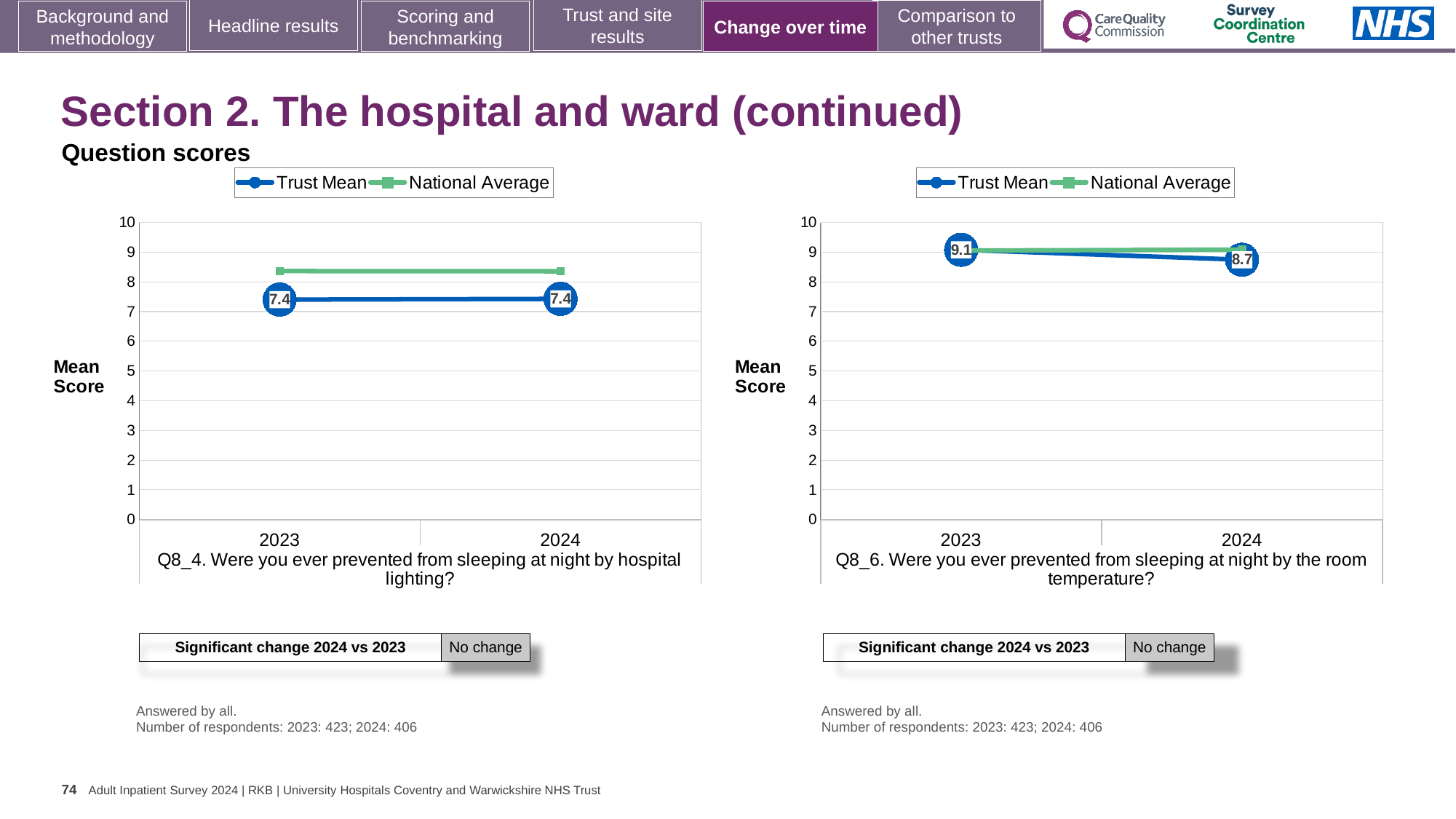
In the left chart (Q8_4, hospital lighting), what is the Trust Mean score for 2024? 7.4 How many years are plotted on the x axis of the right chart? 2 What kind of chart is the left chart (Q8_4, hospital lighting)? line chart In the left chart (Q8_4, hospital lighting), what is the Trust Mean score for 2023? 7.4 In the left chart (Q8_4, hospital lighting), is the National Average for 2024 greater or less than 8? greater How many series does the legend of the left chart list? 2 In the right chart (Q8_6, room temperature), what is the Trust Mean score for 2024? 8.7 In the right chart (Q8_6, room temperature), is the Trust Mean for 2023 greater or less than 9? greater In the right chart (Q8_6, room temperature), by how much did the Trust Mean score change from 2023 to 2024? 0.4 In the left chart (Q8_4, hospital lighting), which series is higher in 2023, Trust Mean or National Average? National Average In the right chart (Q8_6, room temperature), does the Trust Mean rise or fall from 2023 to 2024? fall In the right chart (Q8_6, room temperature), what is the Trust Mean score for 2023? 9.1